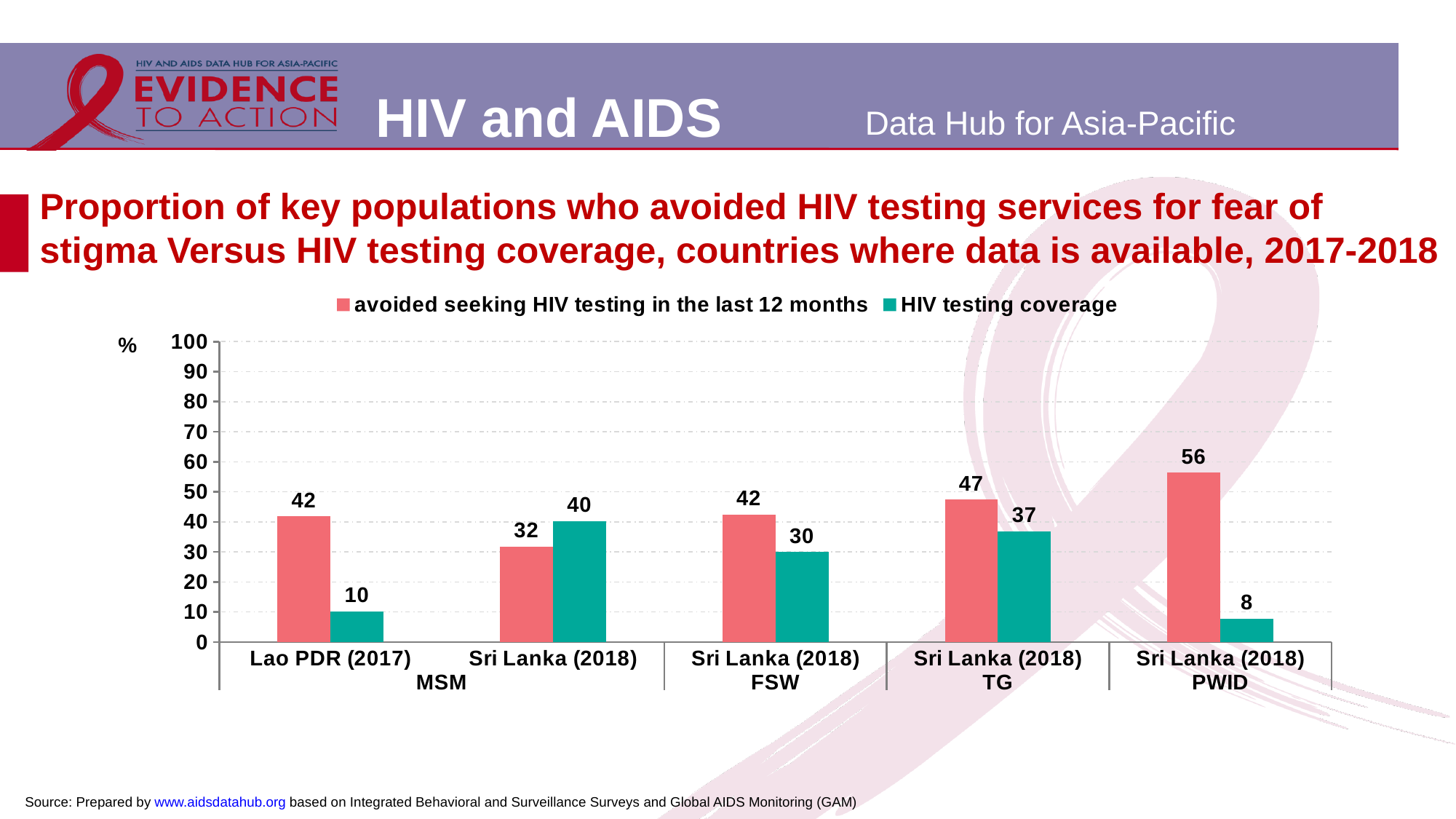
How many categories are shown on the x axis of the chart? 5 What is the value for 'avoided seeking HIV testing in the last 12 months' for Lao PDR (2017) MSM? 42 What colour are the bars for HIV testing coverage? teal/green What kind of chart is shown on the slide? bar chart Which category has the highest value for 'avoided seeking HIV testing in the last 12 months'? Sri Lanka (2018) PWID For Sri Lanka (2018) MSM, which is larger: the 'avoided seeking HIV testing' value or the HIV testing coverage value? HIV testing coverage What is the HIV testing coverage value for Sri Lanka (2018) PWID? 8 Is the 'avoided seeking HIV testing' value for Sri Lanka (2018) PWID greater or less than 50? greater Which category has the lowest HIV testing coverage value? Sri Lanka (2018) PWID How many series does the legend list? 2 What is the difference between the 'avoided seeking HIV testing' value and the HIV testing coverage value for Sri Lanka (2018) TG? 10 What is the HIV testing coverage value for Sri Lanka (2018) FSW? 30